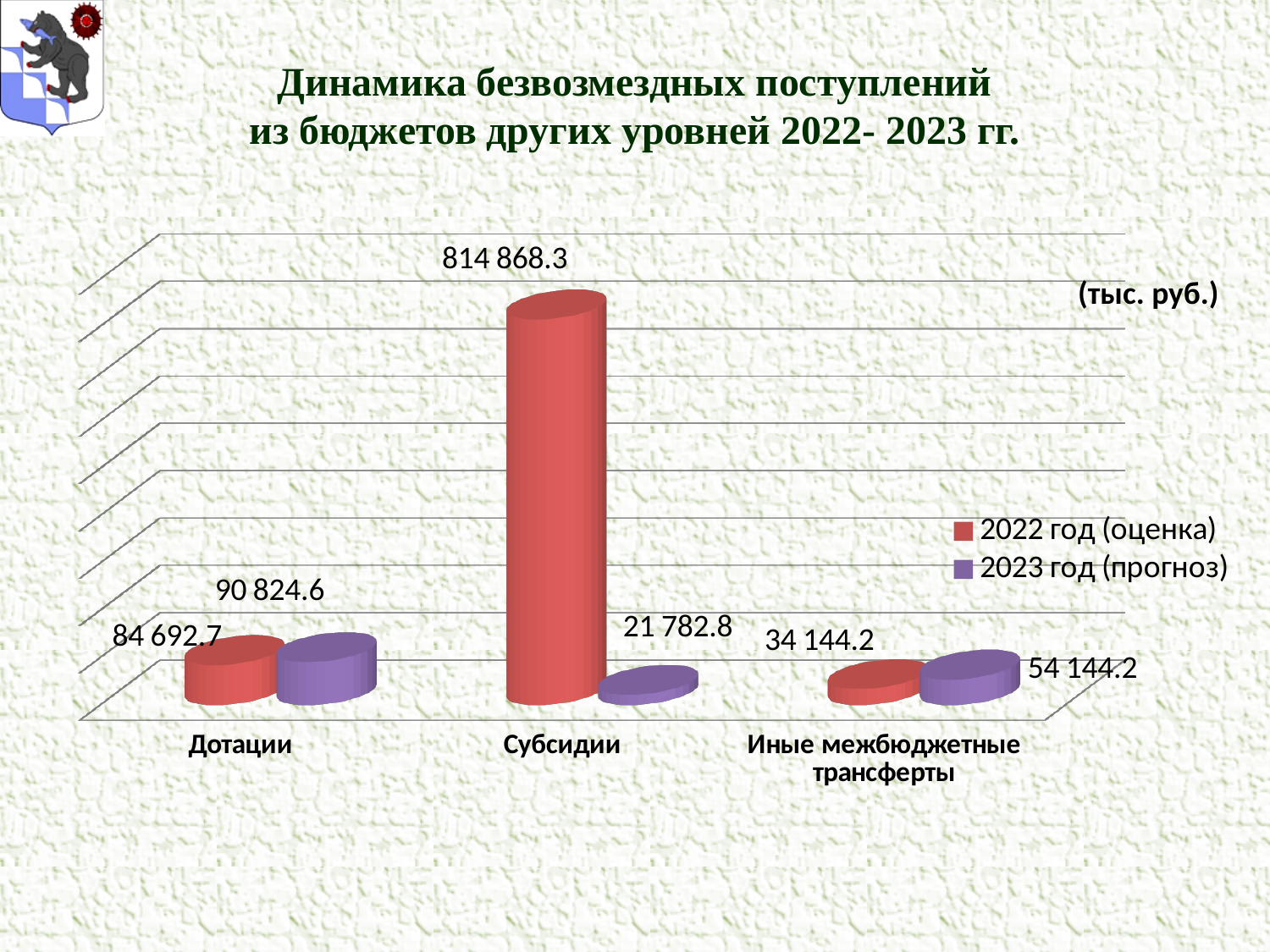
What is the value for Субсидии in the 2023 год (прогноз) series? 21 782.8 How many categories are shown on the x axis? 3 What is the value for Иные межбюджетные трансферты in the 2022 год (оценка) series? 34 144.2 For Субсидии, which is larger: the 2022 год (оценка) value or the 2023 год (прогноз) value? 2022 год (оценка) How many series does the legend list? 2 Which category has the lowest value in the 2023 год (прогноз) series? Субсидии What is the difference between the 2022 год (оценка) and 2023 год (прогноз) values for Иные межбюджетные трансферты? 20 000.0 What is the difference between the 2023 год (прогноз) and 2022 год (оценка) values for Дотации? 6 131.9 Which category has the highest value in the 2022 год (оценка) series? Субсидии What is the value for Дотации in the 2023 год (прогноз) series? 90 824.6 What is the value for Субсидии in the 2022 год (оценка) series? 814 868.3 What kind of chart is shown on the slide? Bar chart